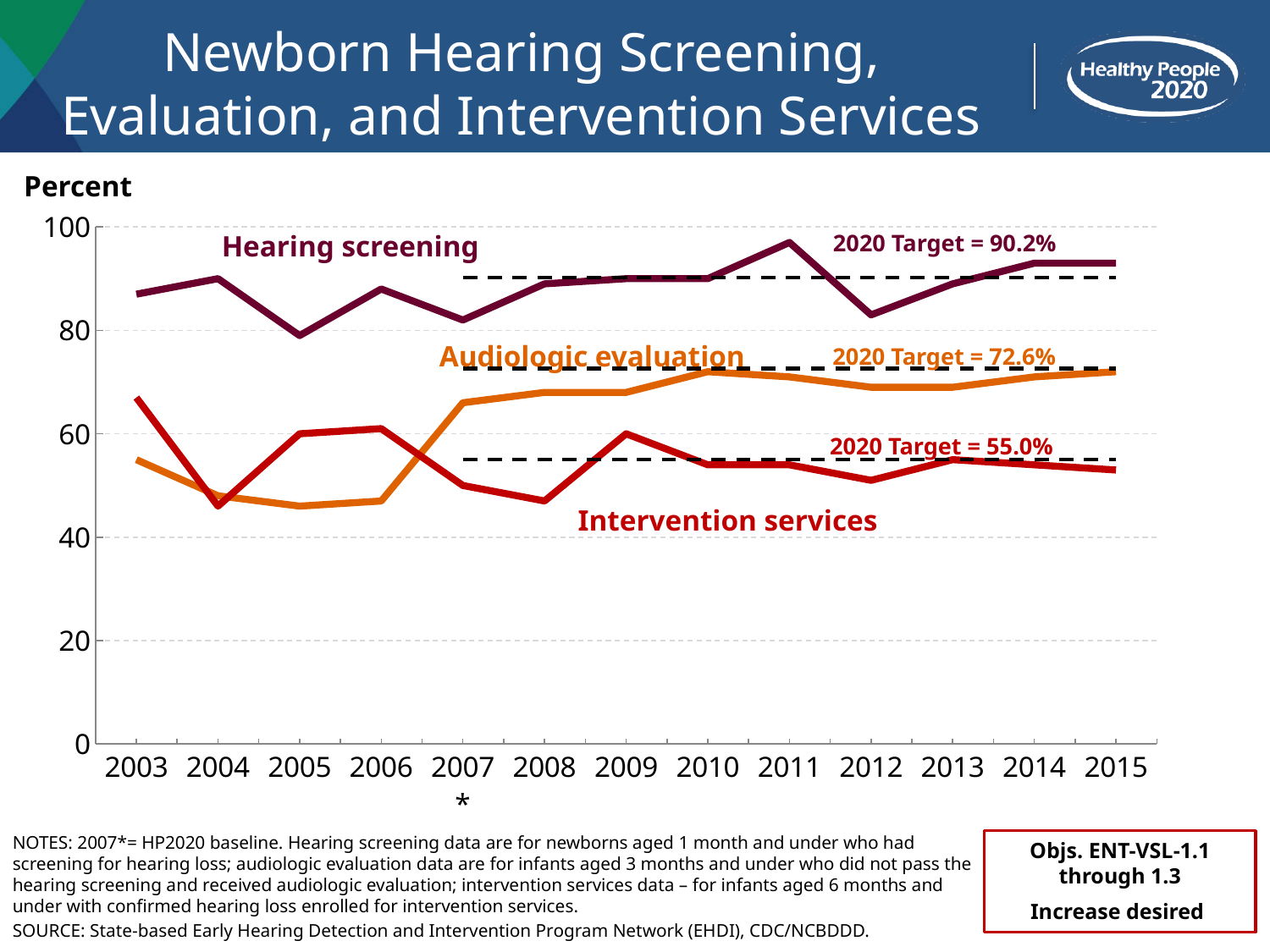
Is the value for hearing screening in 2011 greater or less than 90? greater Does the audiologic evaluation line generally rise or fall from 2007 to 2015? rise What is the 2020 target for audiologic evaluation? 72.6% What is the difference between the 2020 target for hearing screening and the 2020 target for audiologic evaluation? 17.6 percentage points Which series has the highest value in 2015? Hearing screening Is the value for audiologic evaluation in 2004 greater or less than 60? less How many years are shown along the x axis of the chart? 13 In 2015, which is larger: audiologic evaluation or intervention services? audiologic evaluation What kind of chart is shown on the slide? line chart What is the 2020 target for hearing screening? 90.2% What is the 2020 target for intervention services? 55.0%